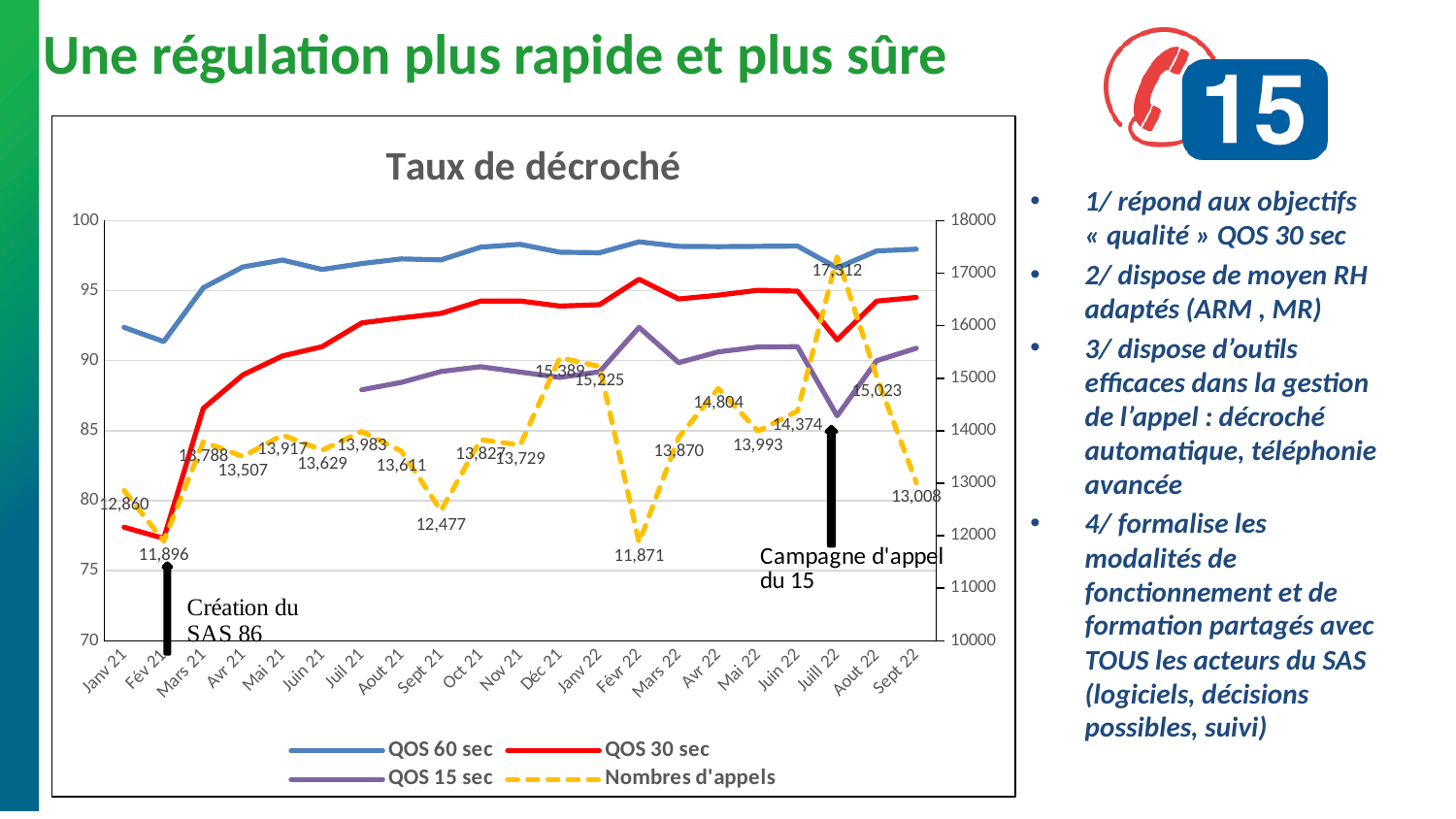
What is the difference between the "Nombres d'appels" values for Juill 22 and Sept 22? 4,304 How many series does the legend of the "Taux de décroché" chart list? 4 What type of chart is shown under the title "Taux de décroché"? line chart Which month has a larger "Nombres d'appels" value, Déc 21 or Janv 22? Déc 21 In which month is "Nombres d'appels" highest? Juill 22 What is the value of "Nombres d'appels" for Avr 22? 14,804 Is the value of "QOS 60 sec" for Janv 21 greater or less than 90? greater What is the value of "Nombres d'appels" for Juill 22? 17,312 Is the value of "QOS 30 sec" for Janv 21 greater or less than 80? less In which month is "Nombres d'appels" lowest? Févr 22 How many months are shown on the x axis of the "Taux de décroché" chart? 21 What is the value of "Nombres d'appels" for Sept 21? 12,477